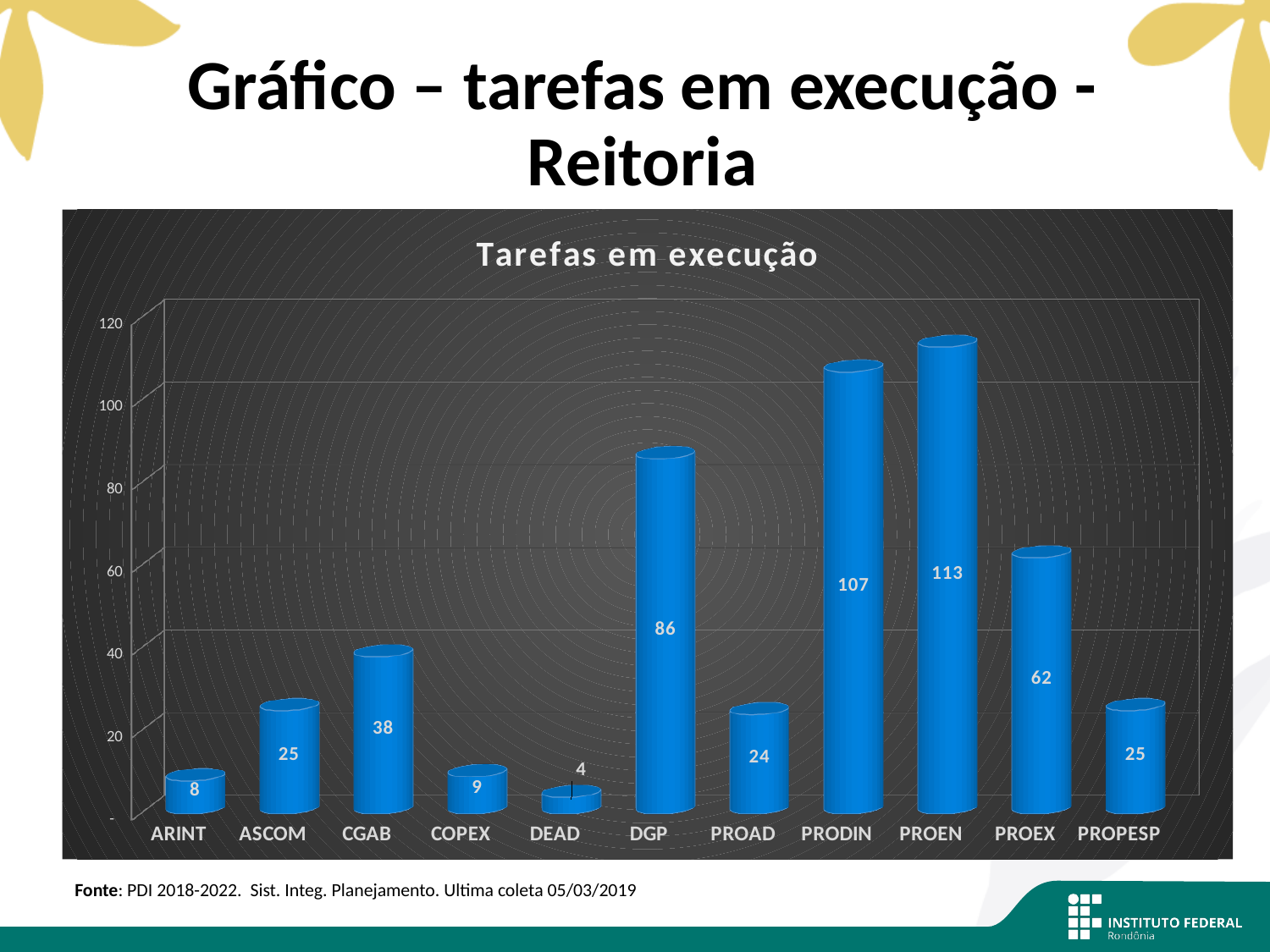
What is the value for PROEX in the Tarefas em execução chart? 62 What is the difference between the values for PROEN and PRODIN? 6 What is the value for DEAD in the Tarefas em execução chart? 4 Which category has the highest value in the Tarefas em execução chart? PROEN What is the difference between the values for CGAB and ASCOM? 13 Which is larger, the value for PROAD or the value for CGAB? CGAB How many categories are shown on the x axis of the Tarefas em execução chart? 11 What is the title of the chart on the slide? Tarefas em execução Is the value for PRODIN greater or less than 100? greater Which category has the lowest value in the Tarefas em execução chart? DEAD What is the value for DGP in the Tarefas em execução chart? 86 What kind of chart is shown on the slide? Bar chart